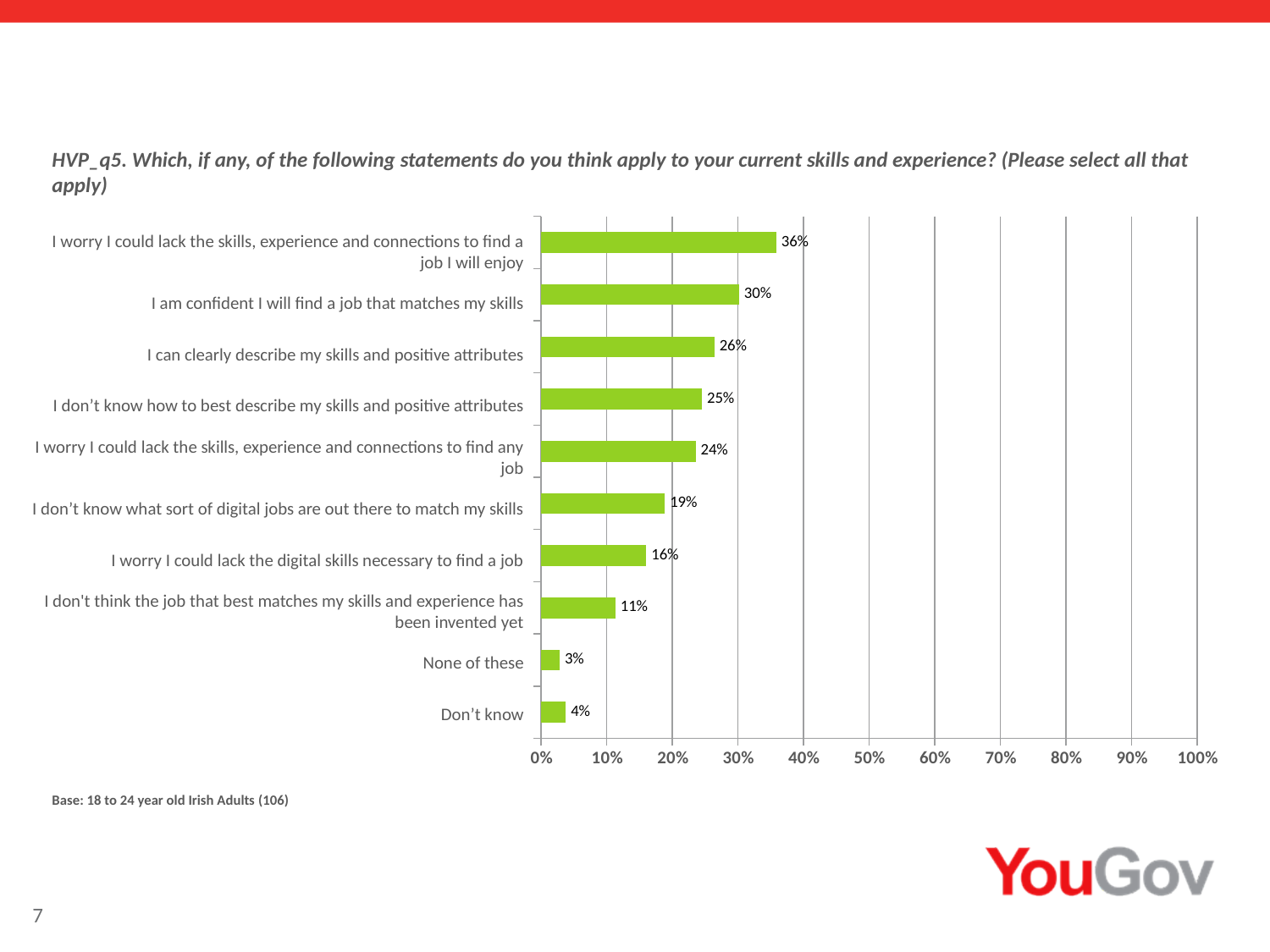
Which category has the lowest percentage? None of these Is the value for "I am confident I will find a job that matches my skills" greater or less than 40%? less What percentage selected "Don't know"? 4% What percentage of respondents said "I am confident I will find a job that matches my skills"? 30% Which is larger: "I worry I could lack the skills, experience and connections to find any job" or "I don't think the job that best matches my skills and experience has been invented yet"? I worry I could lack the skills, experience and connections to find any job What is the value for "I worry I could lack the digital skills necessary to find a job"? 16% Which statement has the highest percentage? I worry I could lack the skills, experience and connections to find a job I will enjoy What type of chart is shown on the slide? Bar chart What is the difference between the highest value and "I don't know what sort of digital jobs are out there to match my skills"? 17% What is the base described below the chart? 18 to 24 year old Irish Adults (106) How many categories are shown in the chart? 10 What is the difference between "I can clearly describe my skills and positive attributes" and "I don't know how to best describe my skills and positive attributes"? 1%